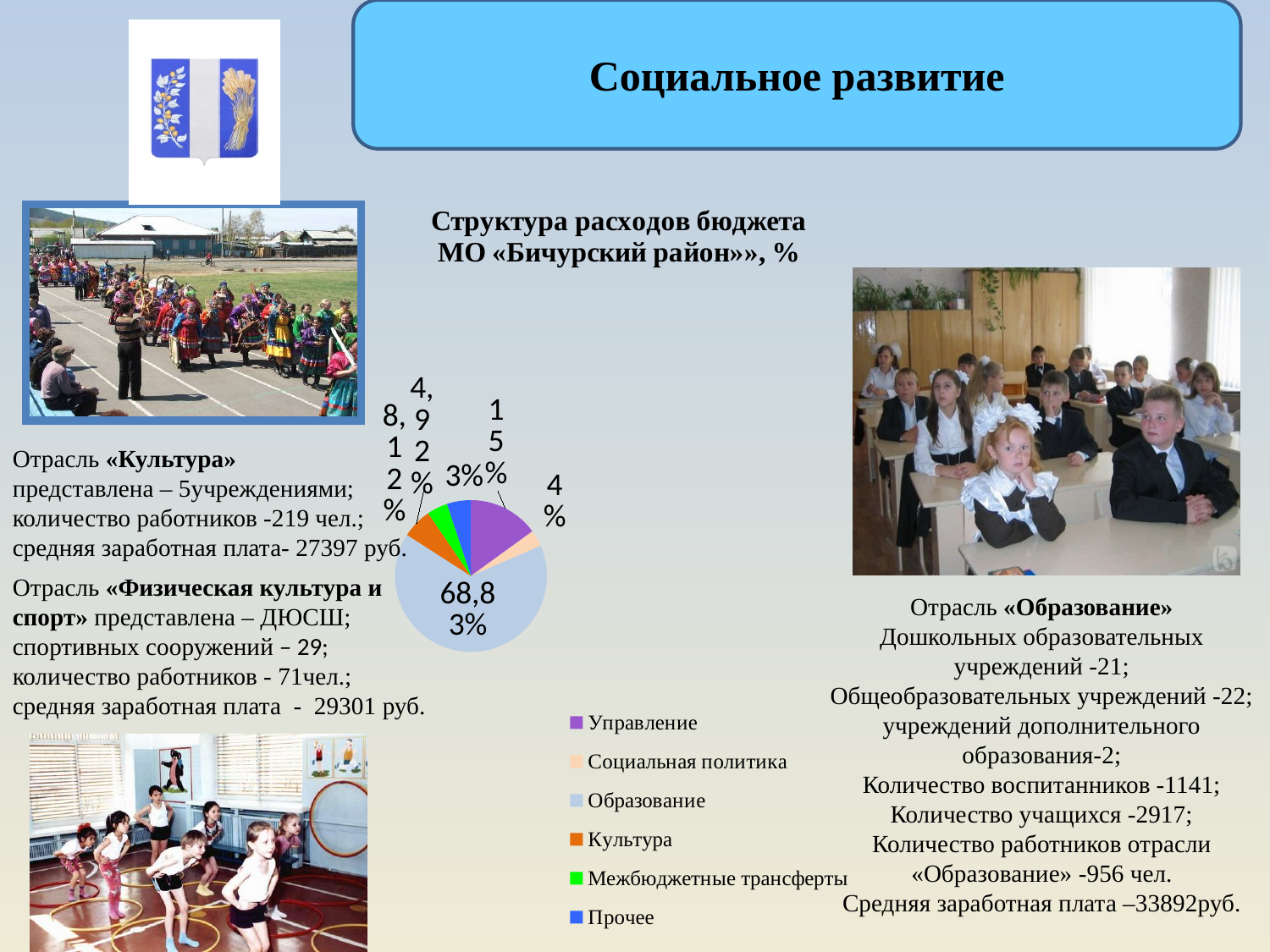
Is the share for Образование greater or less than 50%? greater What is the title of the chart on the slide? Структура расходов бюджета МО «Бичурский район»», % What share of the pie does Образование have? 68,83% How many entries does the chart's legend list? 6 Is the share for Управление greater or less than 50%? less Which colour represents Культура in the legend? orange Which is larger: the share for Образование or the share for Управление? Образование Which category has the largest share of the pie? Образование Which is larger: the share for Образование or the share for Культура? Образование What kind of chart is shown on the slide? pie chart